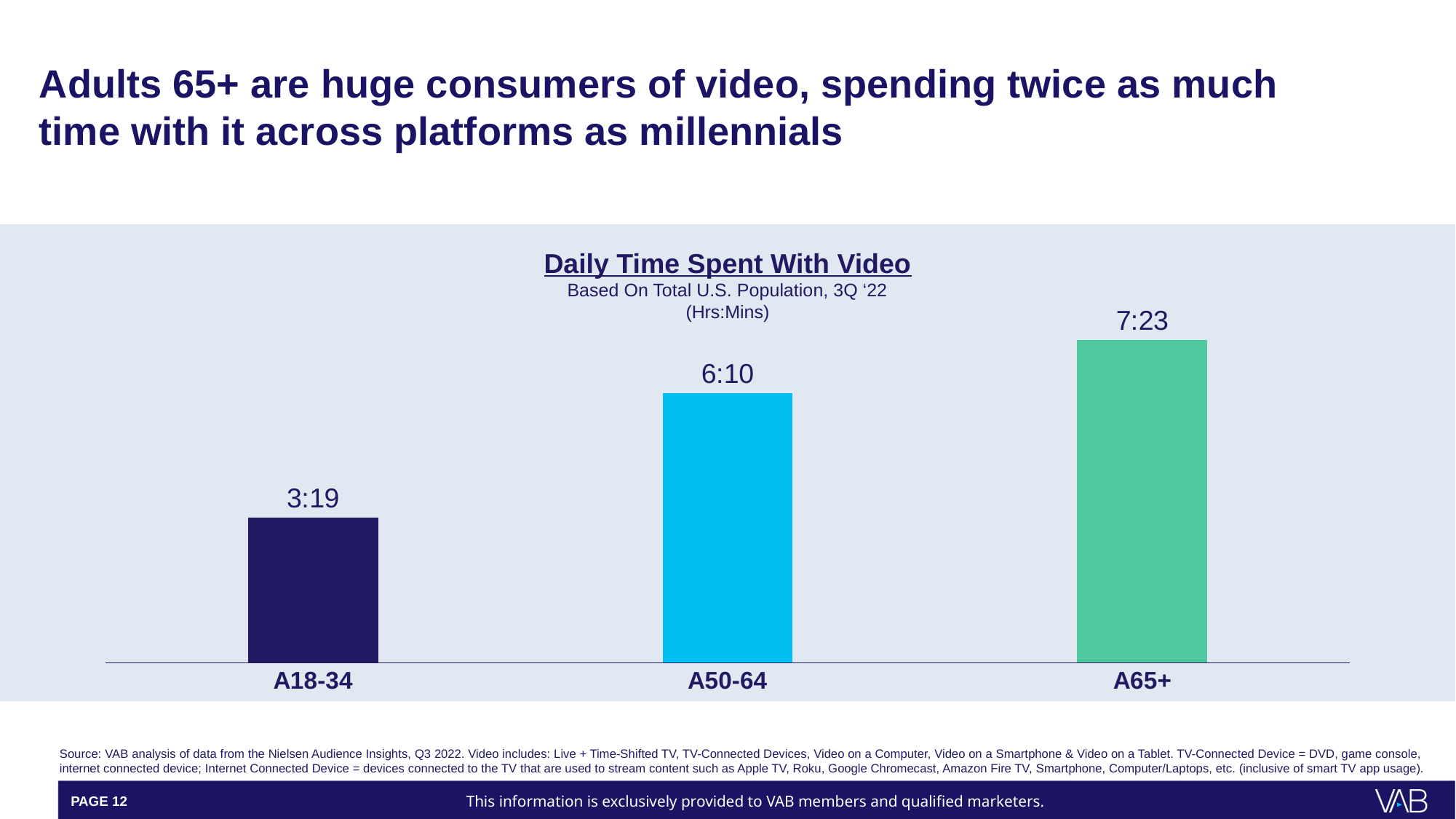
What is the daily time spent with video for A65+? 7:23 Which age group spends the least daily time with video? A18-34 Do the values rise or fall from left to right across the age groups? Rise How many age groups are shown in the chart? 3 What is the title of the chart? Daily Time Spent With Video What is the daily time spent with video for A50-64? 6:10 How much more daily time does A65+ spend with video than A18-34? 4:04 What is the difference in daily time spent with video between A65+ and A50-64? 1:13 What is the daily time spent with video for A18-34? 3:19 Which age group spends the most daily time with video? A65+ Which spends more daily time with video, A50-64 or A18-34? A50-64 What type of chart is shown on the slide? Bar chart